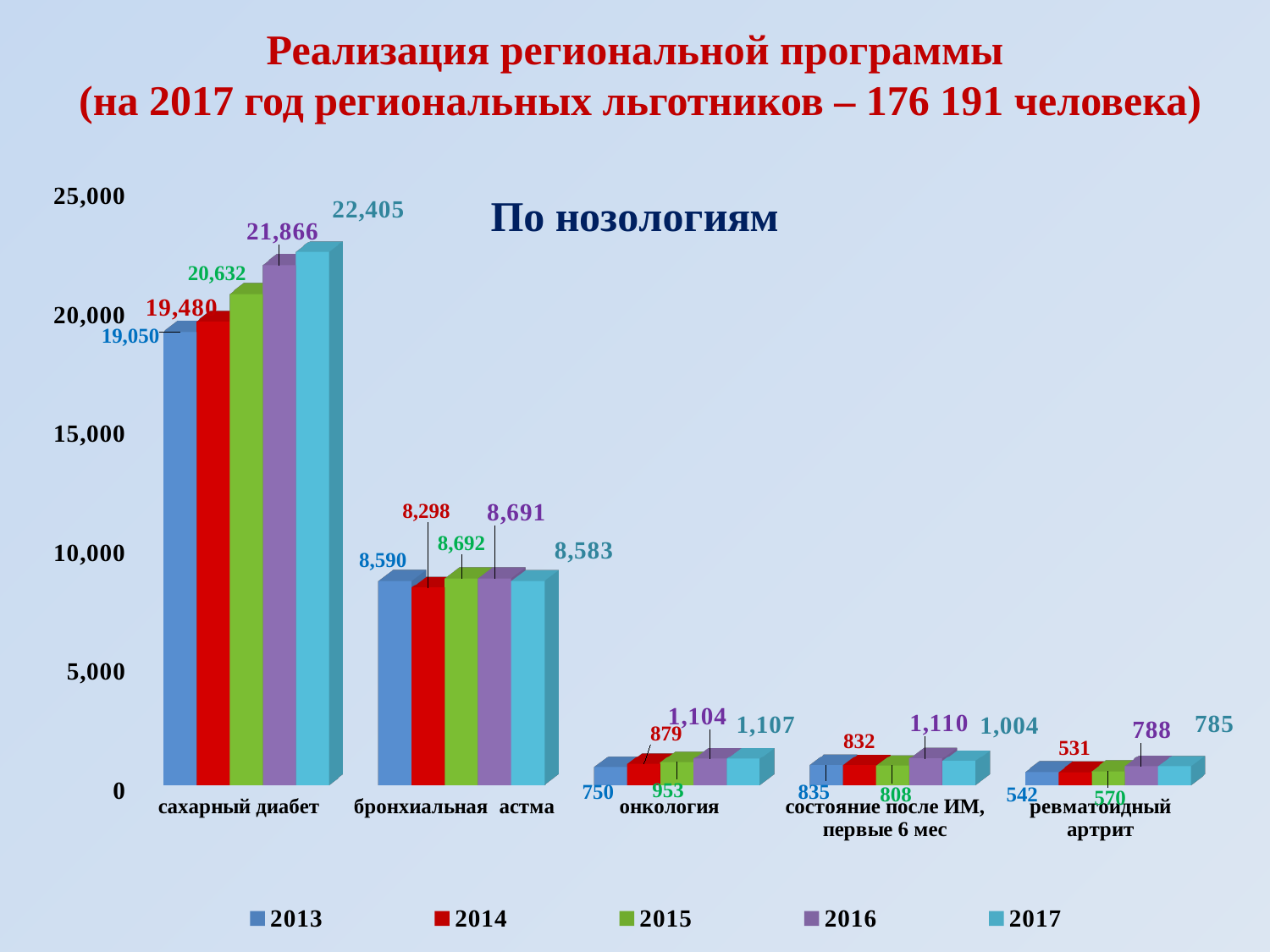
What kind of chart is shown on the slide? bar chart Which category has the highest value in 2017? сахарный диабет How many series does the legend list? 5 Which category has the lowest value in 2013? ревматоидный артрит What is the difference between the 2017 and 2013 values for сахарный диабет? 3,355 What is the value for онкология in 2013? 750 Which is larger for состояние после ИМ, первые 6 мес: the 2016 value or the 2017 value? 2016 What is the value for ревматоидный артрит in 2016? 788 Do the values for сахарный диабет rise or fall from 2013 to 2017? rise How many categories are shown on the x axis? 5 What is the value for сахарный диабет in 2017? 22,405 What is the value for бронхиальная астма in 2014? 8,298